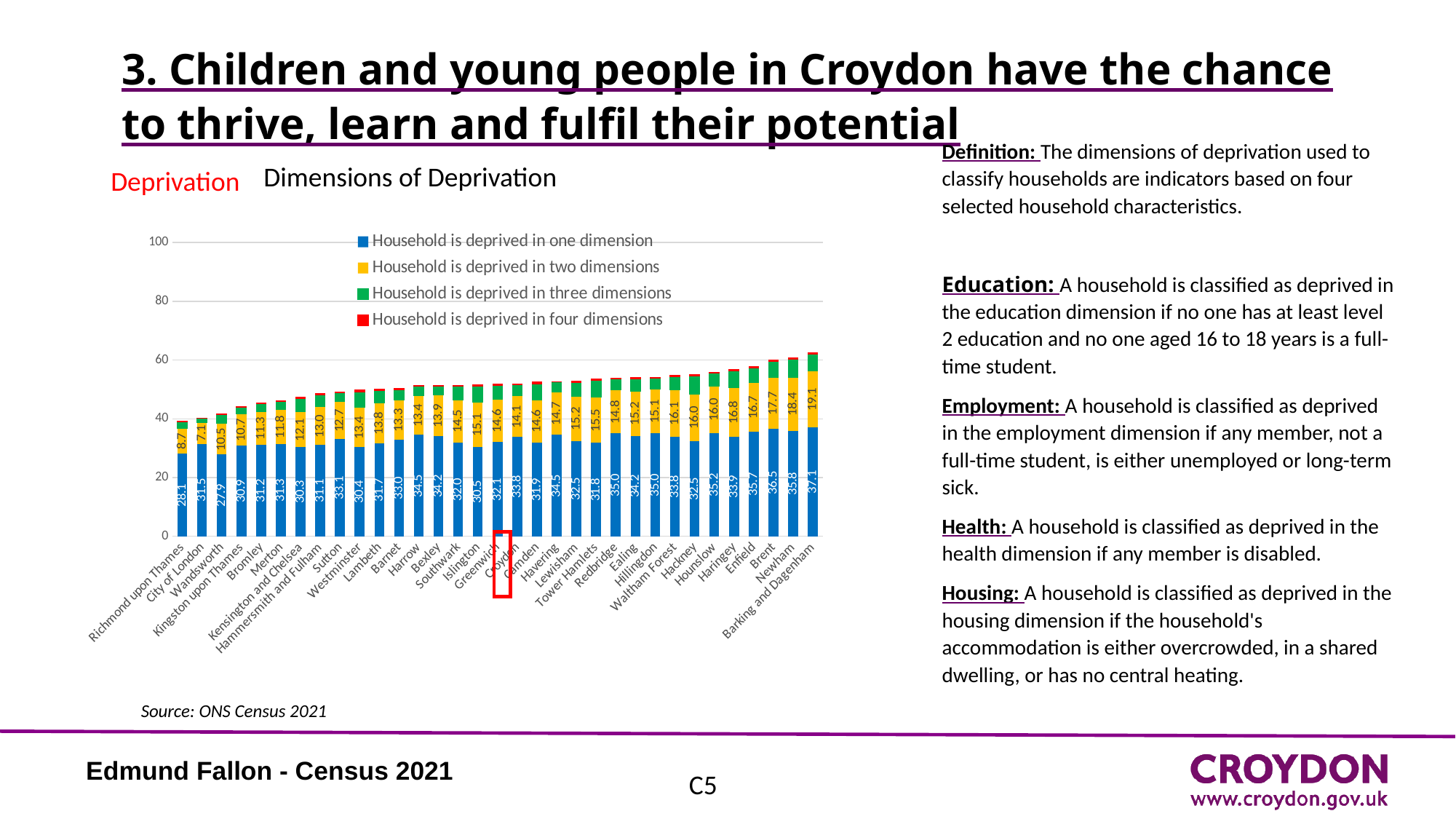
What is the difference between Barking and Dagenham and Richmond upon Thames in the 'Household is deprived in one dimension' series? 9.0 Which borough has the lowest value in the 'Household is deprived in two dimensions' series? City of London How many boroughs are shown along the x axis of the Dimensions of Deprivation chart? 33 What is the value for Barking and Dagenham in the 'Household is deprived in two dimensions' series? 19.1 What is the value for Croydon in the 'Household is deprived in two dimensions' series? 14.1 Is the total stacked value for Croydon greater or less than 60? less Which borough has the highest value in the 'Household is deprived in one dimension' series? Barking and Dagenham Which has the larger value in the 'Household is deprived in one dimension' series, Croydon or Camden? Croydon What kind of chart is shown on the slide? Stacked bar chart What is the value for Croydon in the 'Household is deprived in one dimension' series? 33.8 How many series does the legend of the Dimensions of Deprivation chart list? 4 Do the total bar heights generally rise or fall from left to right along the x axis? Rise